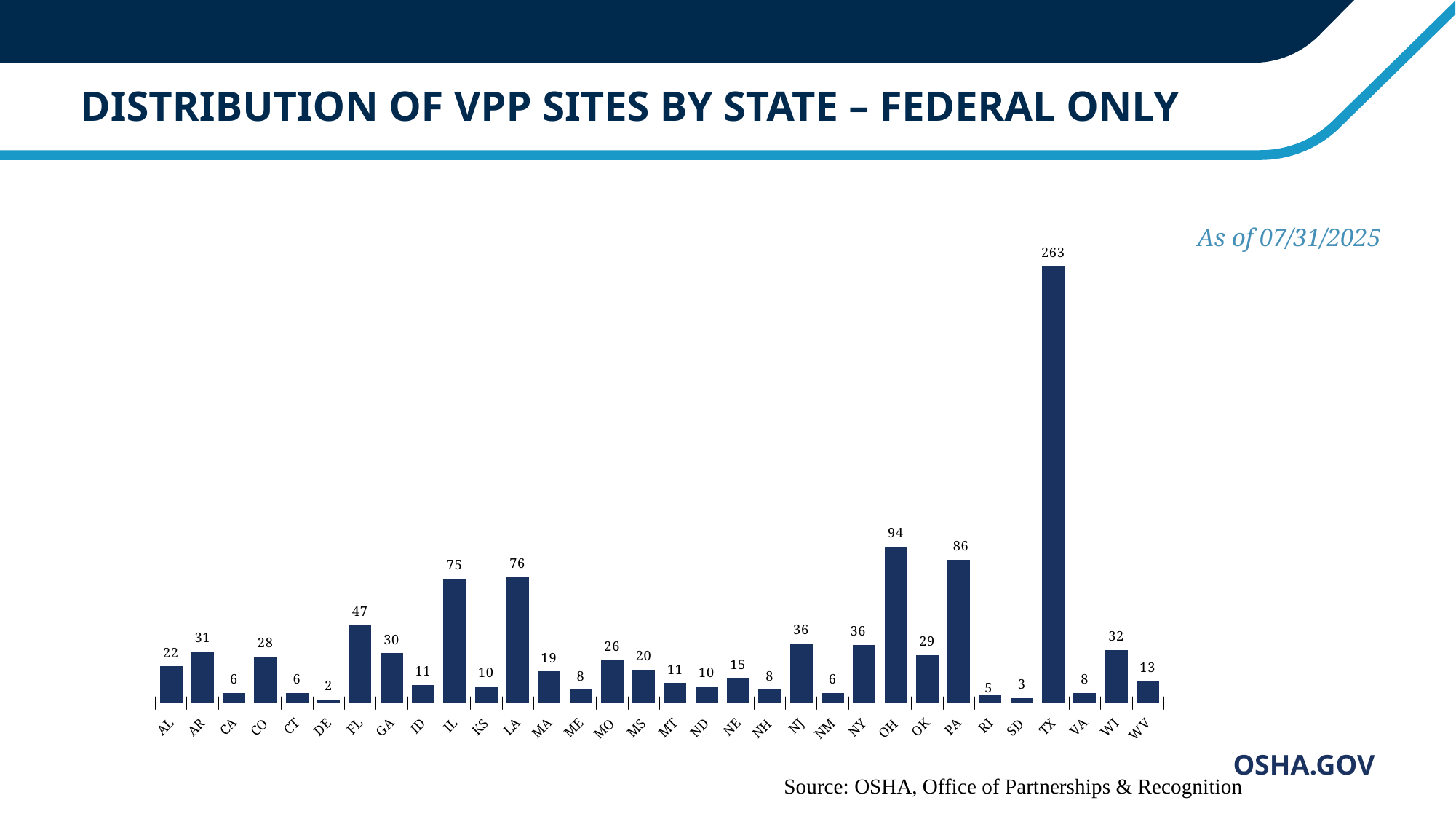
What is the difference between the values for OH and PA? 8 What is the difference between the values for TX and OH? 169 How many states are shown on the x axis of the chart? 32 What is the value for WV? 13 How many VPP sites does TX have? 263 Which has a larger value, FL or GA? FL What kind of chart is shown on the slide? bar chart Which state has the lowest number of VPP sites? DE How many VPP sites does OH have? 94 What is the value for FL? 47 Which state has the highest number of VPP sites? TX What date is the chart data current as of? 07/31/2025